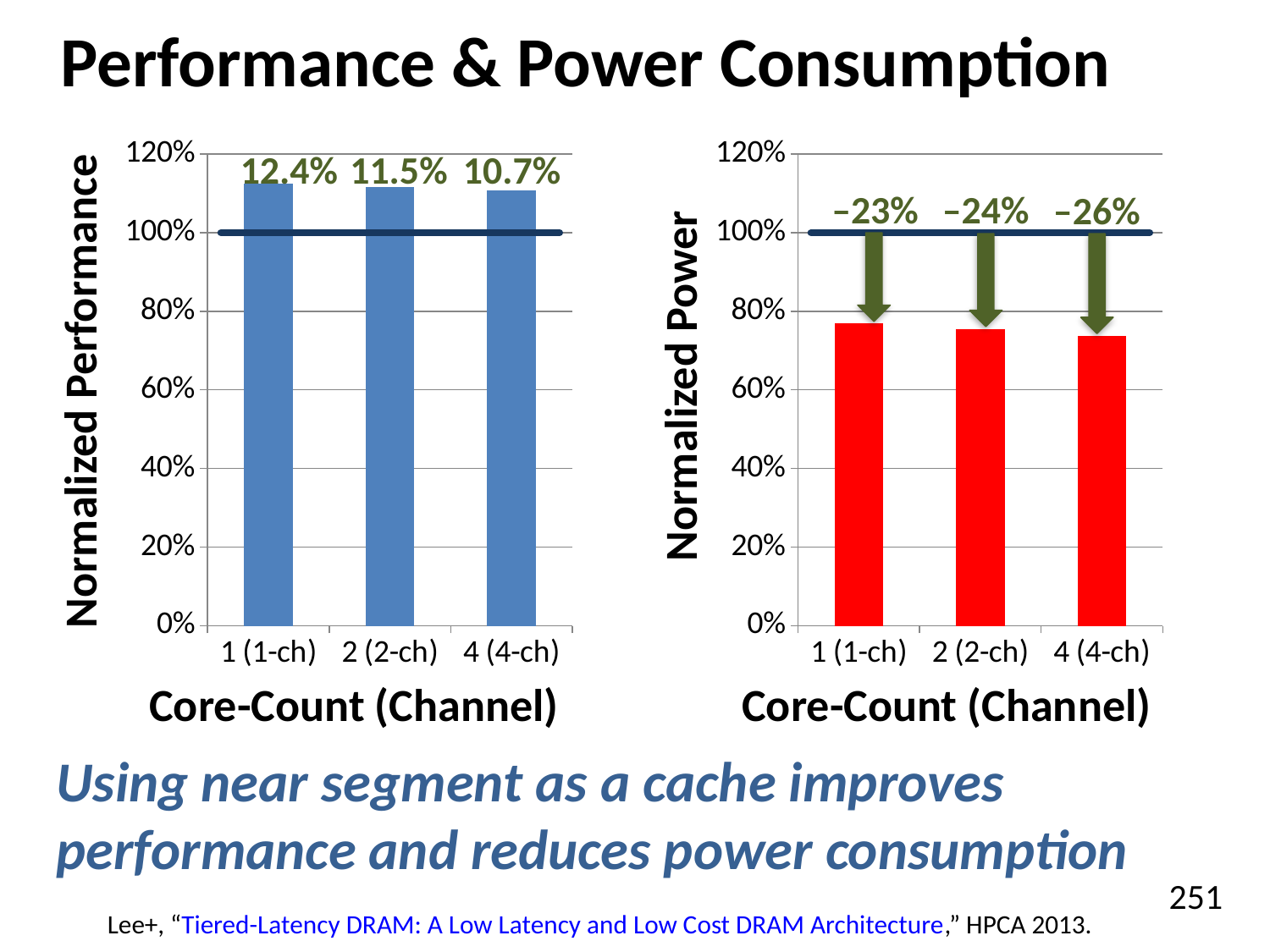
In the Normalized Performance chart, is the bar for 2 (2-ch) greater or less than 100%? greater How many core-count configurations are plotted in the Normalized Performance chart? 3 In the Normalized Power chart, what reduction label is shown above the bar for 4 (4-ch)? –26% In the Normalized Performance chart, what percentage label is shown above the bar for 1 (1-ch)? 12.4% In the Normalized Performance chart, what percentage label is shown above the bar for 4 (4-ch)? 10.7% In the Normalized Power chart, which core-count configuration has the lowest normalized power bar? 4 (4-ch) What is the x-axis title of the Normalized Performance chart? Core-Count (Channel) In the Normalized Power chart, what reduction label is shown above the bar for 2 (2-ch)? –24% In the Normalized Power chart, is the bar for 1 (1-ch) greater or less than 80%? less In the Normalized Power chart, is the bar for 4 (4-ch) greater or less than 60%? greater What kind of chart is the Normalized Power chart? bar chart In the Normalized Performance chart, which core-count configuration has the largest labelled performance improvement? 1 (1-ch)